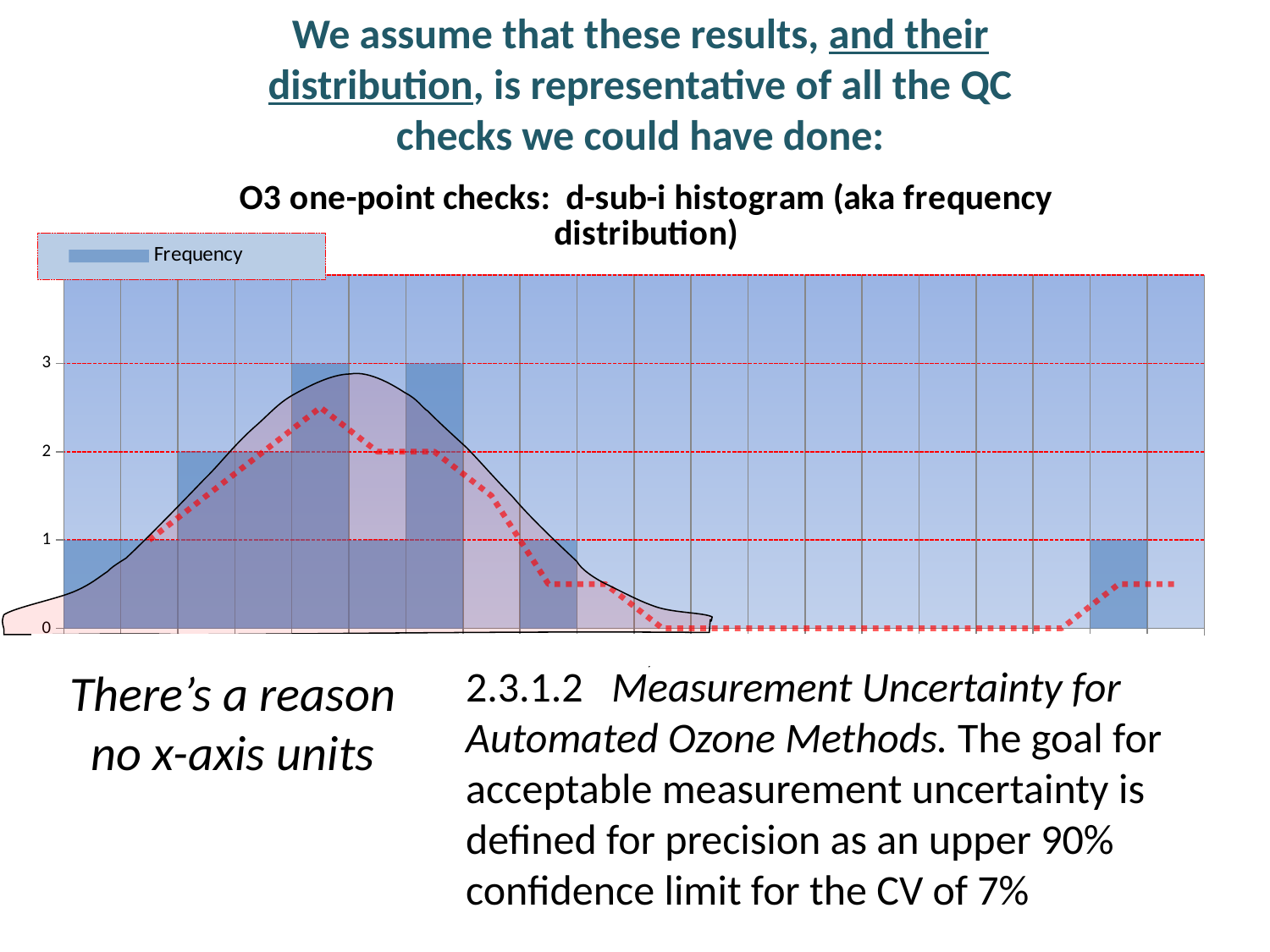
Is the tallest bar in the histogram greater or less than 2? greater What kind of chart is shown on the slide? bar chart What is the name of the series shown in the chart's legend? Frequency What is the highest tick label shown on the y axis of the histogram? 3 What is the highest frequency value reached by any bar in the histogram? 3 What is the frequency value of the rightmost non-zero bar in the histogram? 1 How many series does the chart's legend list? 1 Which is larger, the frequency of the leftmost bar or the frequency of the tallest bar? the tallest bar How many bars in the histogram reach a frequency of 3? 2 What is the frequency value of the leftmost bar in the histogram? 1